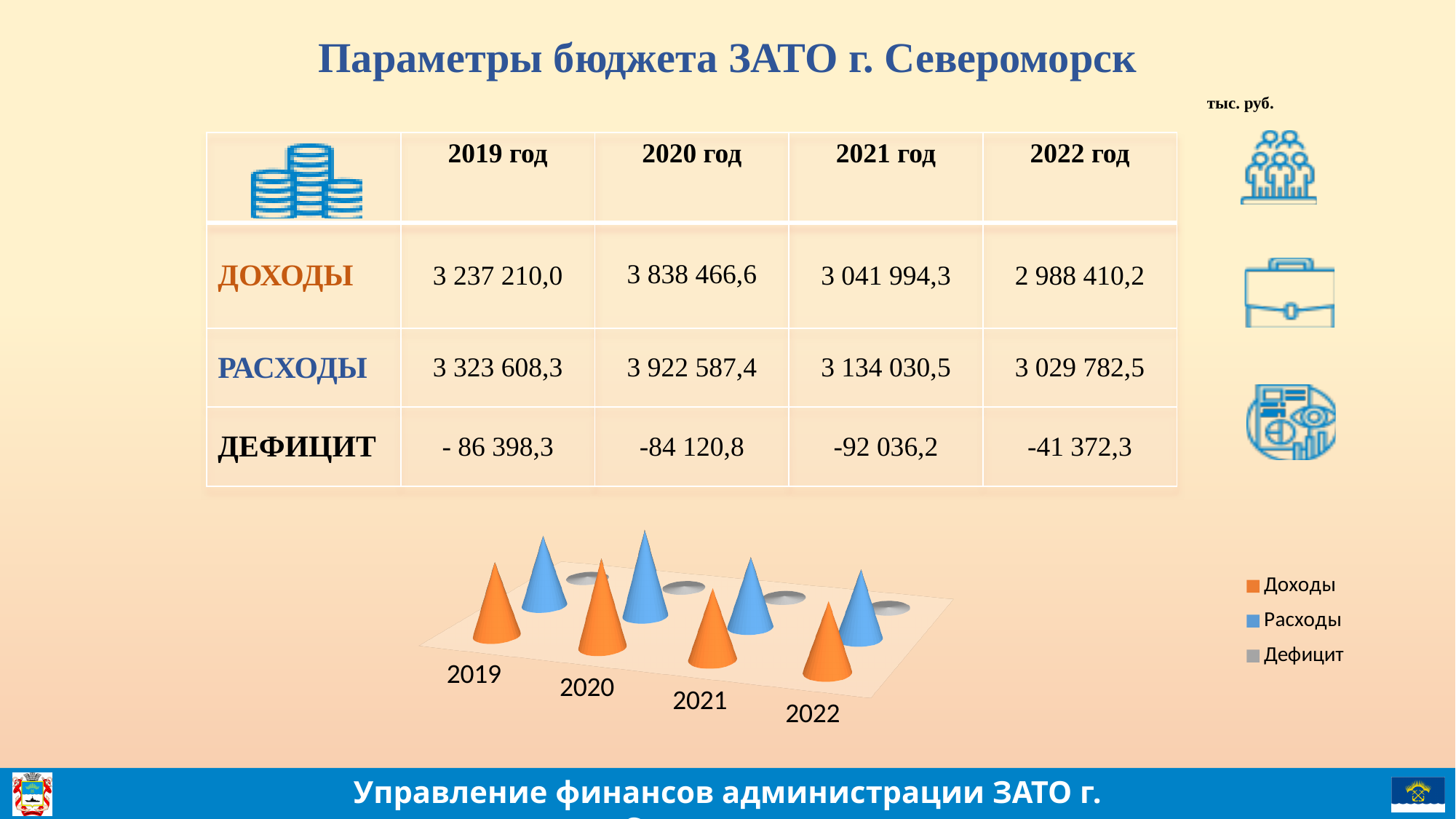
What kind of chart is shown at the bottom of the slide? bar chart (3D cone-shaped bars) What is the difference between Расходы and Доходы in 2020 год? 84 120,8 What is the value of Расходы for 2022 год? 3 029 782,5 What is the value of Доходы for 2020 год? 3 838 466,6 Which is larger in 2019 год, Доходы or Расходы? Расходы In which year is Расходы the lowest? 2022 Do the Доходы values rise or fall from 2020 to 2022? fall How many years (categories) are shown along the x axis of the chart? 4 How many series does the chart legend list? 3 In which year is Доходы the highest? 2020 Which colour represents Расходы in the chart legend? blue What is the value of Дефицит for 2021 год? -92 036,2